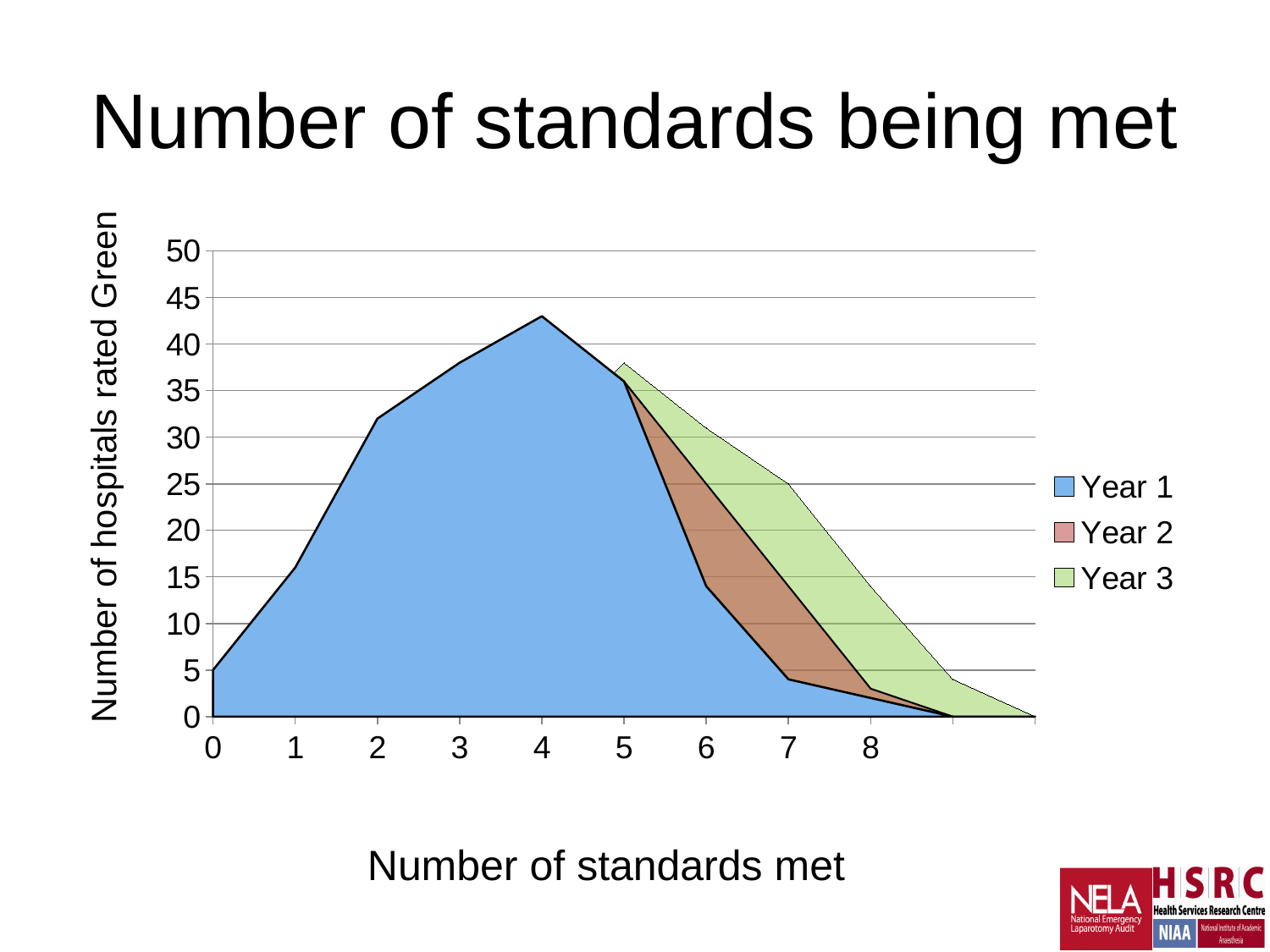
At 7 standards met, which series has the larger value, Year 1 or Year 3? Year 3 Is the Year 1 value at 6 standards met greater or less than 20? less What kind of chart is shown on the slide? Area chart At which number of standards met does the Year 1 series reach its highest value? 4 Is the Year 3 value at 7 standards met greater or less than 20? greater Does the Year 1 series rise or fall between 4 and 8 standards met? fall Is the Year 1 value at 0 standards met greater or less than 10? less What is the title of the vertical axis? Number of hospitals rated Green What are the series names listed in the legend? Year 1, Year 2, Year 3 How many series does the legend list? 3